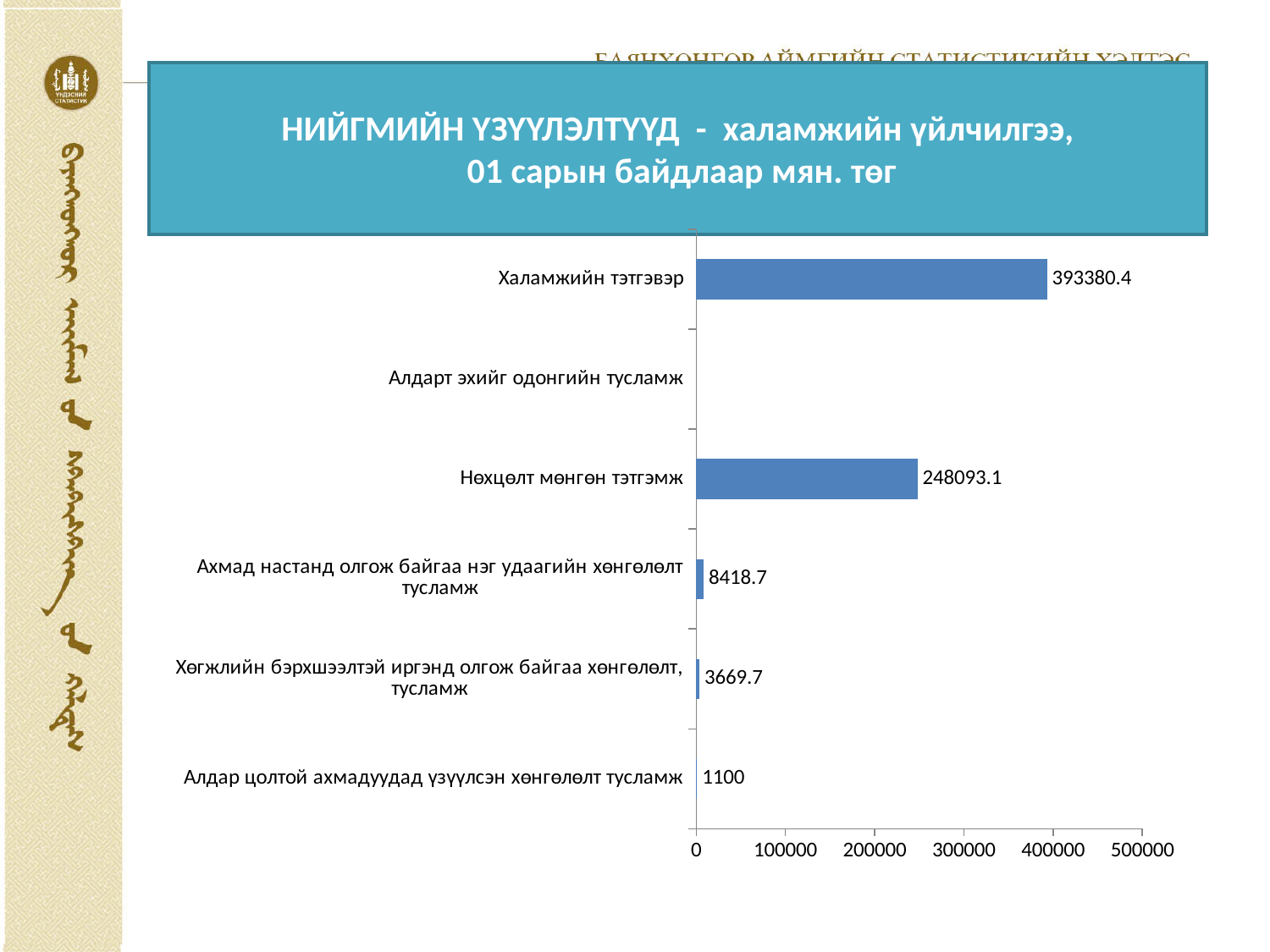
What is the value for Хөгжлийн бэрхшээлтэй иргэнд олгож байгаа хөнгөлөлт, тусламж? 3669.7 What is the title of the chart on the slide? НИЙГМИЙН ҮЗҮҮЛЭЛТҮҮД - халамжийн үйлчилгээ, 01 сарын байдлаар мян. төг Which category has the highest value? Халамжийн тэтгэвэр What is the value for Халамжийн тэтгэвэр? 393380.4 What is the value for Нөхцөлт мөнгөн тэтгэмж? 248093.1 What is the difference between the values for Халамжийн тэтгэвэр and Нөхцөлт мөнгөн тэтгэмж? 145287.3 Is the value for Нөхцөлт мөнгөн тэтгэмж greater or less than 300000? less What type of chart is shown on the slide? bar chart What is the value for Алдар цолтой ахмадуудад үзүүлсэн хөнгөлөлт тусламж? 1100 Which is larger: the value for Ахмад настанд олгож байгаа нэг удаагийн хөнгөлөлт тусламж or the value for Хөгжлийн бэрхшээлтэй иргэнд олгож байгаа хөнгөлөлт, тусламж? Ахмад настанд олгож байгаа нэг удаагийн хөнгөлөлт тусламж What is the value for Ахмад настанд олгож байгаа нэг удаагийн хөнгөлөлт тусламж? 8418.7 How many categories are shown on the chart? 6